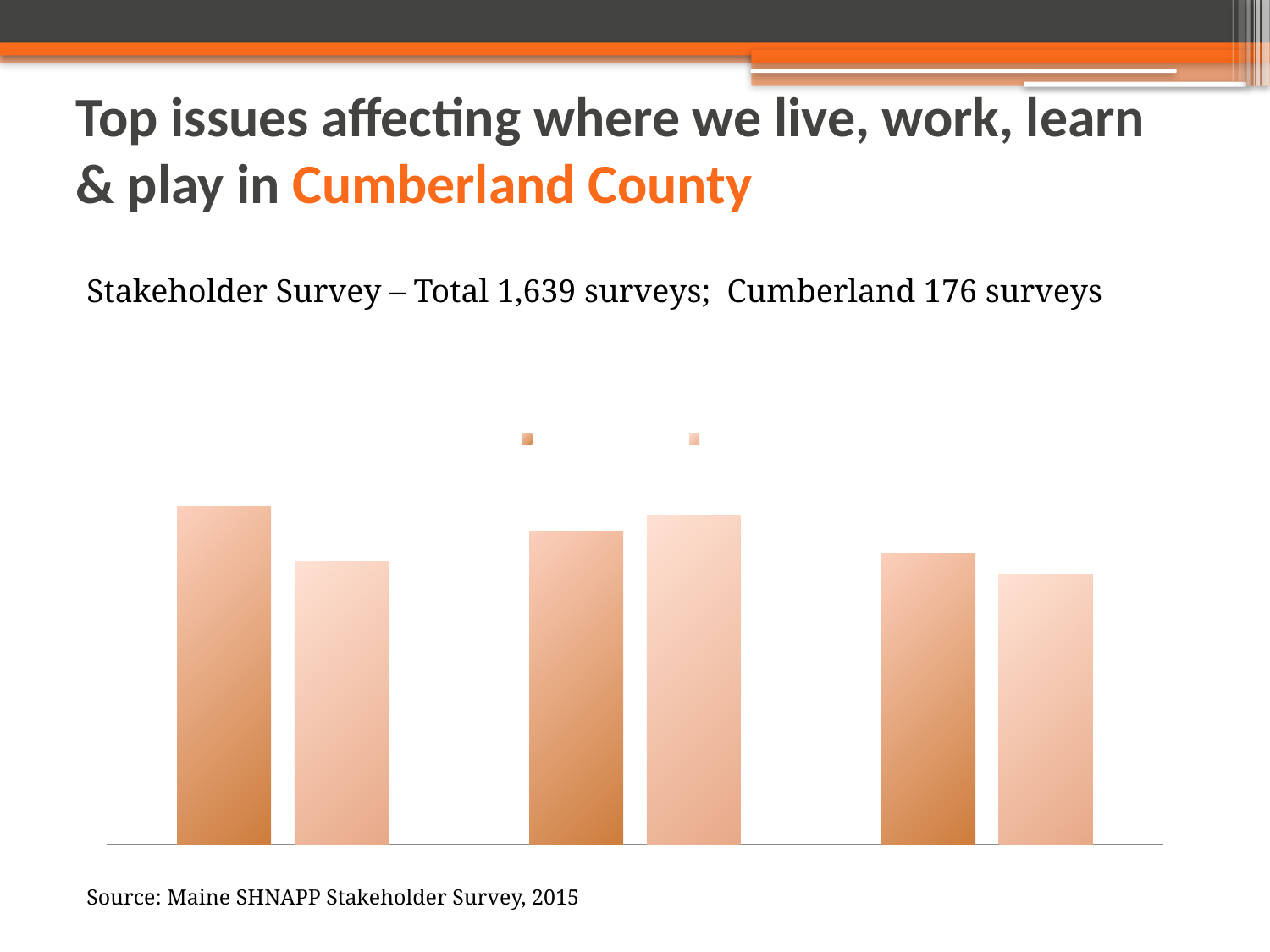
Are the bars in the chart vertical or horizontal? vertical How many bars are plotted in total on the chart? 6 How many groups of bars does the chart show? 3 What two colours are used for the bars in the chart? dark orange and light orange What kind of chart is shown on the slide? bar chart How many series does the chart's legend show? 2 In the leftmost group of bars, is the darker orange bar or the lighter orange bar taller? the darker orange bar Which group of bars is the only one where the lighter orange bar is taller than the darker orange bar? the middle group In the rightmost group of bars, is the darker orange bar or the lighter orange bar taller? the darker orange bar